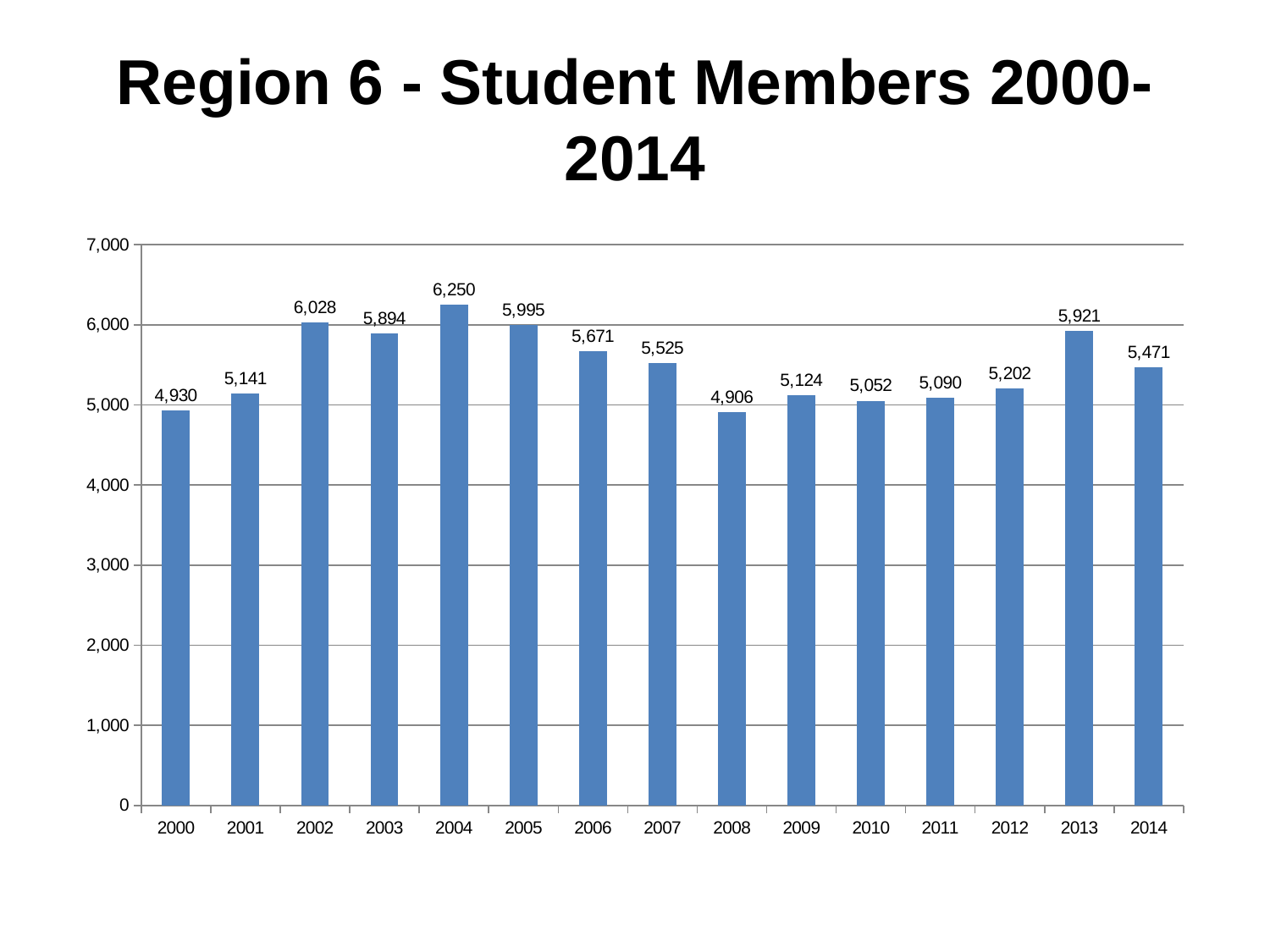
What is the difference in student members between 2004 and 2008? 1,344 How many years are shown on the x axis? 15 Which year has the lowest number of student members? 2008 Which year has the highest number of student members? 2004 What kind of chart is shown on the slide? bar chart What is the number of student members in 2014? 5,471 What is the title of the slide? Region 6 - Student Members 2000-2014 What is the number of student members in 2004? 6,250 Is the value for 2007 greater or less than 5,000? greater Which year has more student members, 2002 or 2005? 2002 What is the number of student members in 2008? 4,906 What is the difference in student members between 2013 and 2014? 450